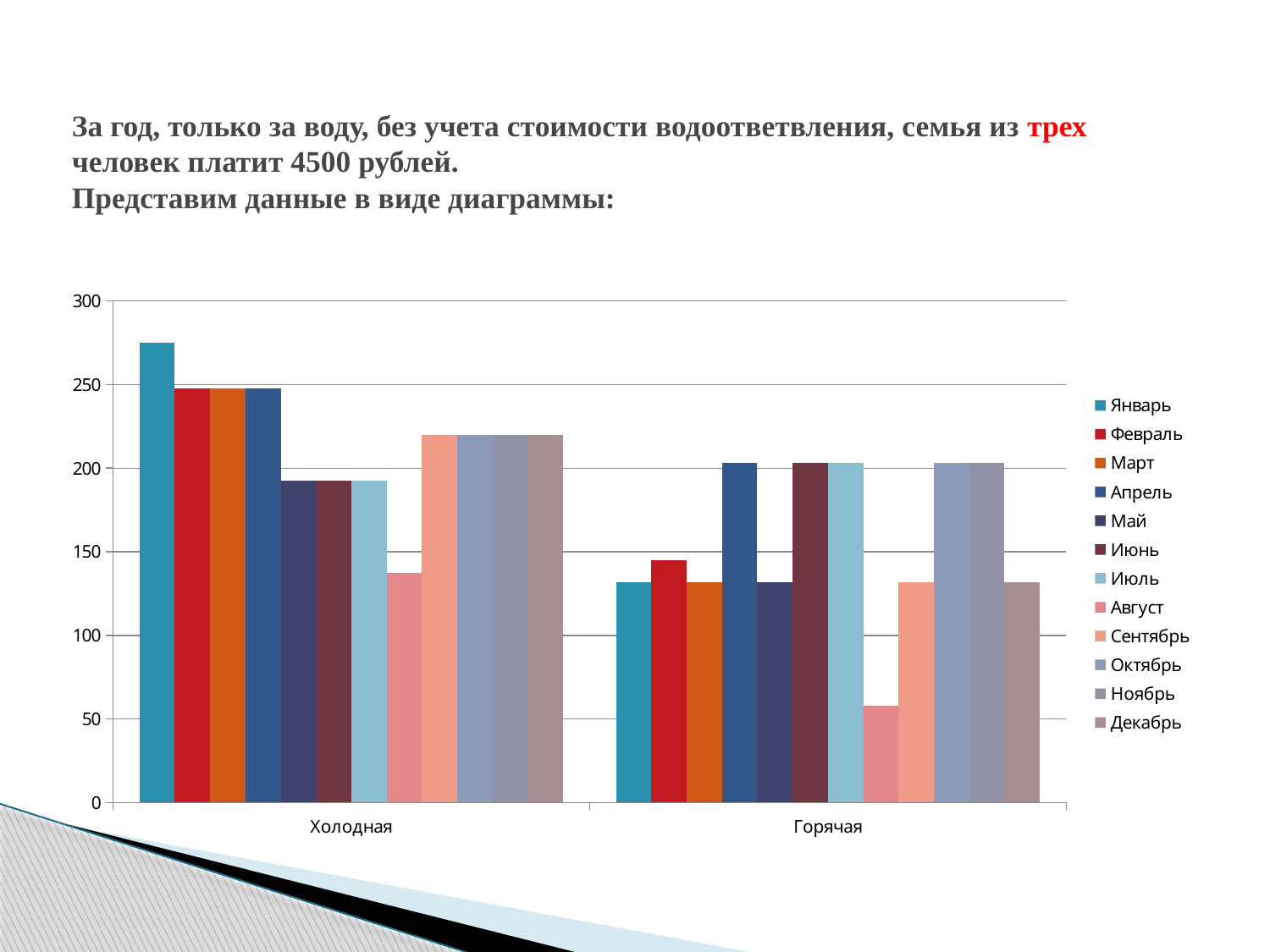
Which month has the lowest value for Горячая? Август Is the value for Август in the Горячая category greater or less than 100? less Is the value for Апрель in the Горячая category greater or less than 150? greater How many categories are shown on the x axis of the chart? 2 How many series does the chart's legend list? 12 Is the value for Январь in the Холодная category greater or less than 250? greater Which month has the lowest value for Холодная? Август Which month has the highest value for Холодная? Январь Which is larger: the Январь value for Холодная or the Январь value for Горячая? Холодная What are the two category labels on the x axis of the chart? Холодная and Горячая What kind of chart is shown on the slide? bar chart